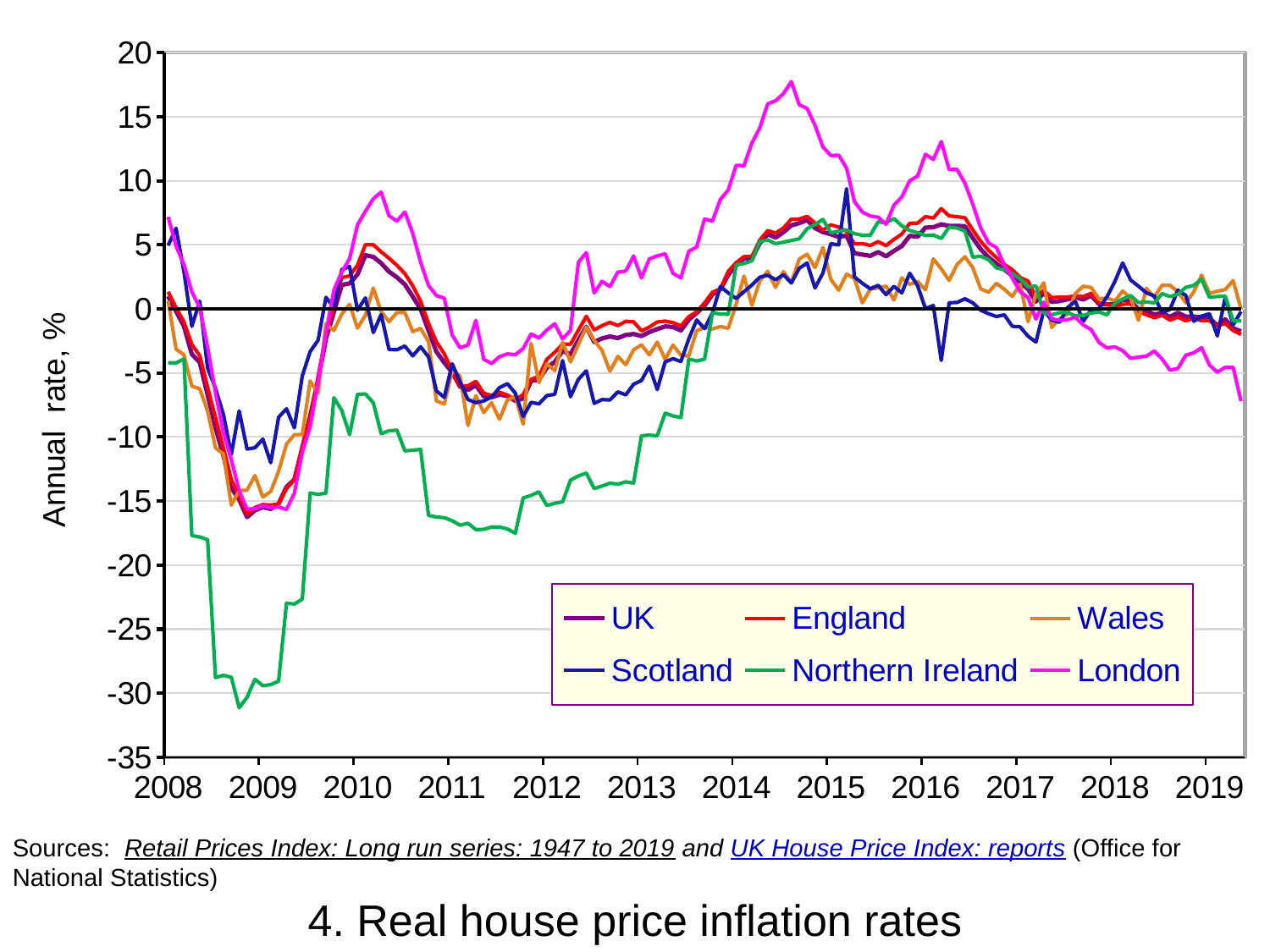
Around the start of 2012, which series is higher: London or Northern Ireland? London Is the value for London at the end of 2019 greater or less than -5? less Which series reaches the highest value on the chart? London Which series reaches the lowest value on the chart? Northern Ireland What kind of chart is shown on the slide? line chart Is the peak value for London, reached around late 2014, greater or less than 15? greater What is the label on the vertical axis? Annual rate, % Is the lowest value for Northern Ireland, reached around 2009, greater or less than -25? less Does the London series rise or fall between 2017 and 2019? fall Around the start of 2009, which series is higher: Scotland or Northern Ireland? Scotland How many series does the legend list? 6